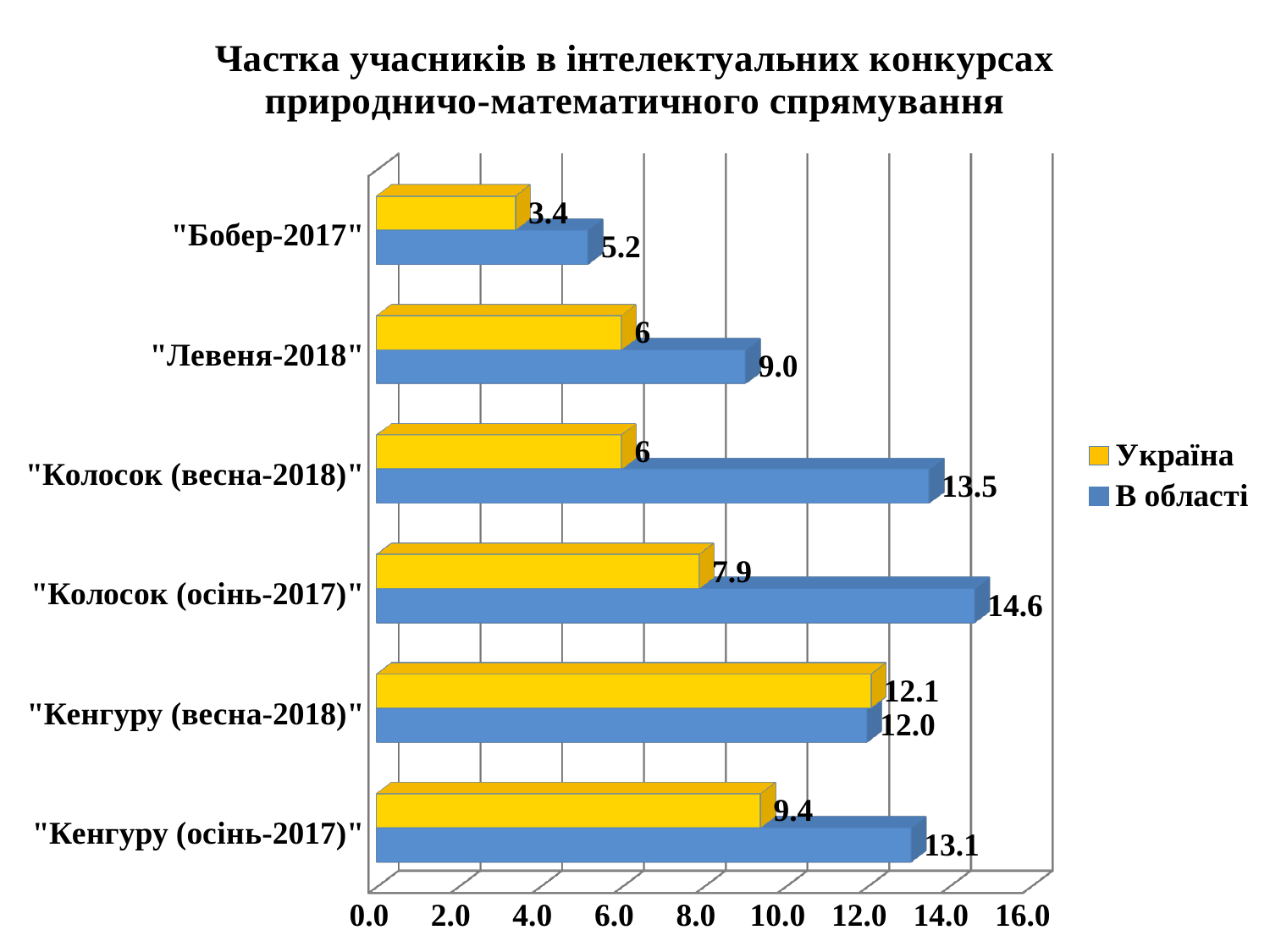
Which category has the lowest value in the Україна series? "Бобер-2017" What kind of chart is shown on the slide? Bar chart How many categories are shown on the chart? 6 What is the value for "Колосок (осінь-2017)" in the В області series? 14.6 What is the value for "Кенгуру (осінь-2017)" in the Україна series? 9.4 How many series does the legend list? 2 What is the difference between the В області and Україна values for "Колосок (осінь-2017)"? 6.7 Which is larger for "Колосок (весна-2018)": the Україна value or the В області value? В області What is the value for "Левеня-2018" in the В області series? 9.0 What is the value for "Бобер-2017" in the Україна series? 3.4 What is the difference between the В області and Україна values for "Бобер-2017"? 1.8 Which category has the highest value in the В області series? "Колосок (осінь-2017)"